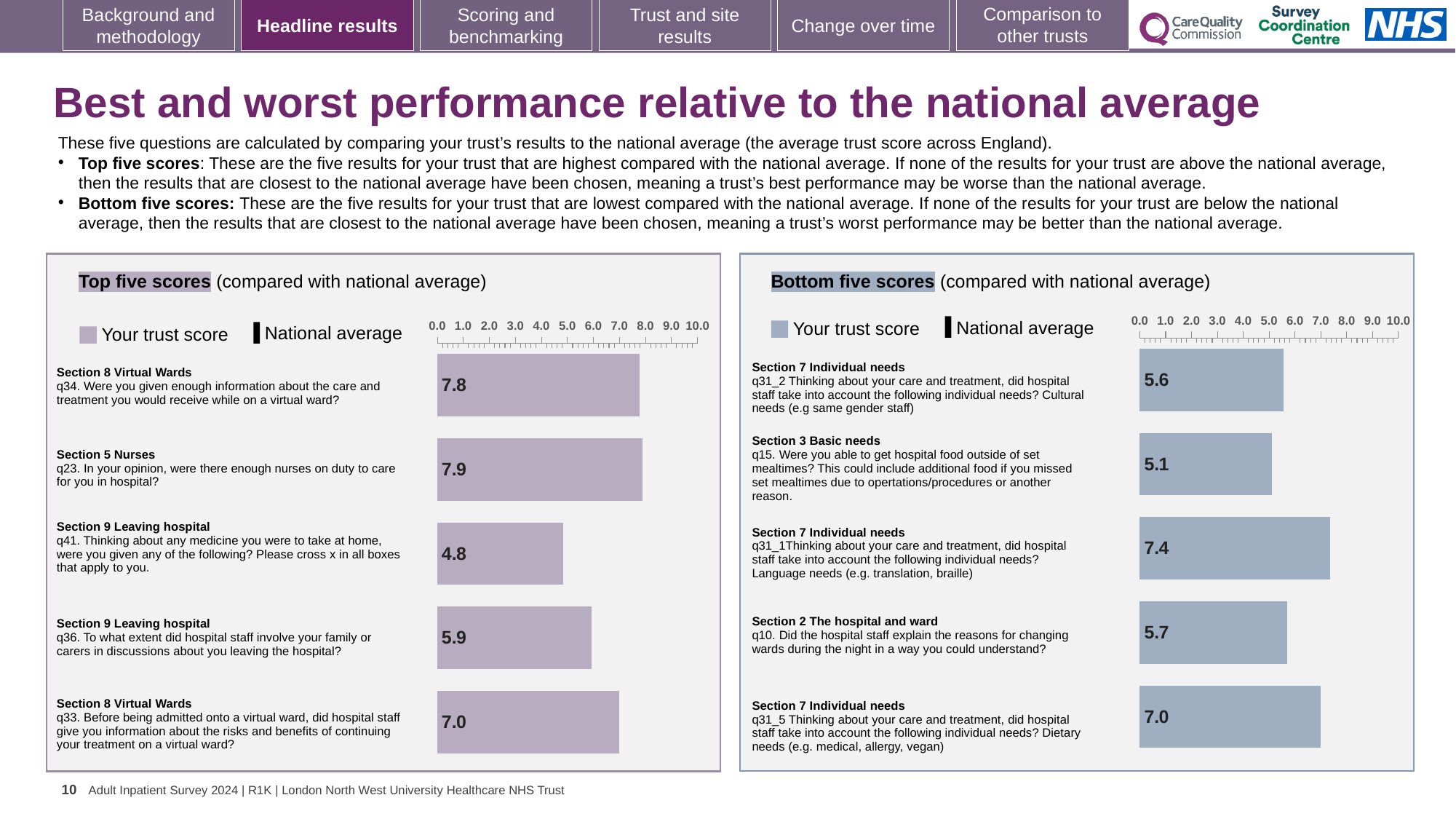
In the Top five scores chart, what is the trust score for q23 (were there enough nurses on duty to care for you in hospital)? 7.9 In the Bottom five scores chart, what is the trust score for q15 (hospital food outside of set mealtimes)? 5.1 In the Top five scores chart, what is the difference between the trust scores for q23 and q41? 3.1 In the Bottom five scores chart, is the trust score for q31_1 greater or less than 6.0? greater In the Bottom five scores chart, which question has the lowest trust score? q15 (Section 3 Basic needs) In the Bottom five scores chart, what is the trust score for q31_5 (dietary needs)? 7.0 In the Top five scores chart, what is the trust score for q41 (medicine you were to take at home)? 4.8 How many questions are plotted in the Bottom five scores chart? 5 How many series does the legend of the Top five scores chart list? 2 In the Bottom five scores chart, what is the difference between the trust scores for q31_1 and q15? 2.3 In the Top five scores chart, which has the larger trust score, q34 or q33? q34 In the Top five scores chart, which question has the highest trust score? q23 (Section 5 Nurses)